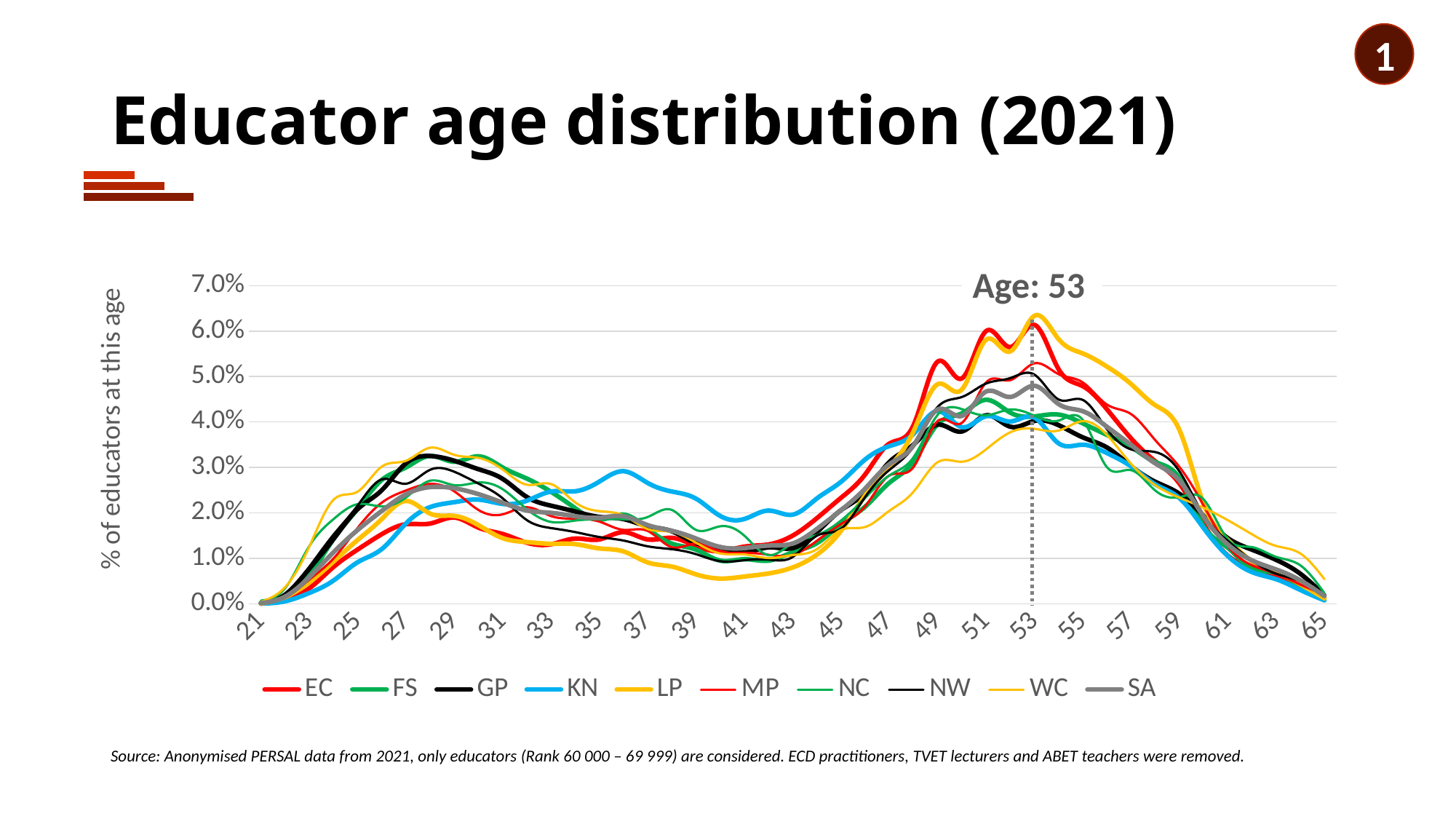
What is the highest value shown on the vertical axis? 7.0% Which series has the lowest value at age 41? LP What is the first age shown on the horizontal axis? 21 At which age is the dotted vertical line annotation placed? Age: 53 Is the value for KN at age 37 greater or less than 2.0%? greater How many series does the legend list? 10 Do the values generally rise or fall between age 41 and age 53? rise What kind of chart is shown on the slide? line chart Is the value for LP at age 41 greater or less than 1.0%? less What is the label on the vertical axis? % of educators at this age What is the title of the slide's chart? Educator age distribution (2021) Is the value for LP at age 53 greater or less than 6.0%? greater